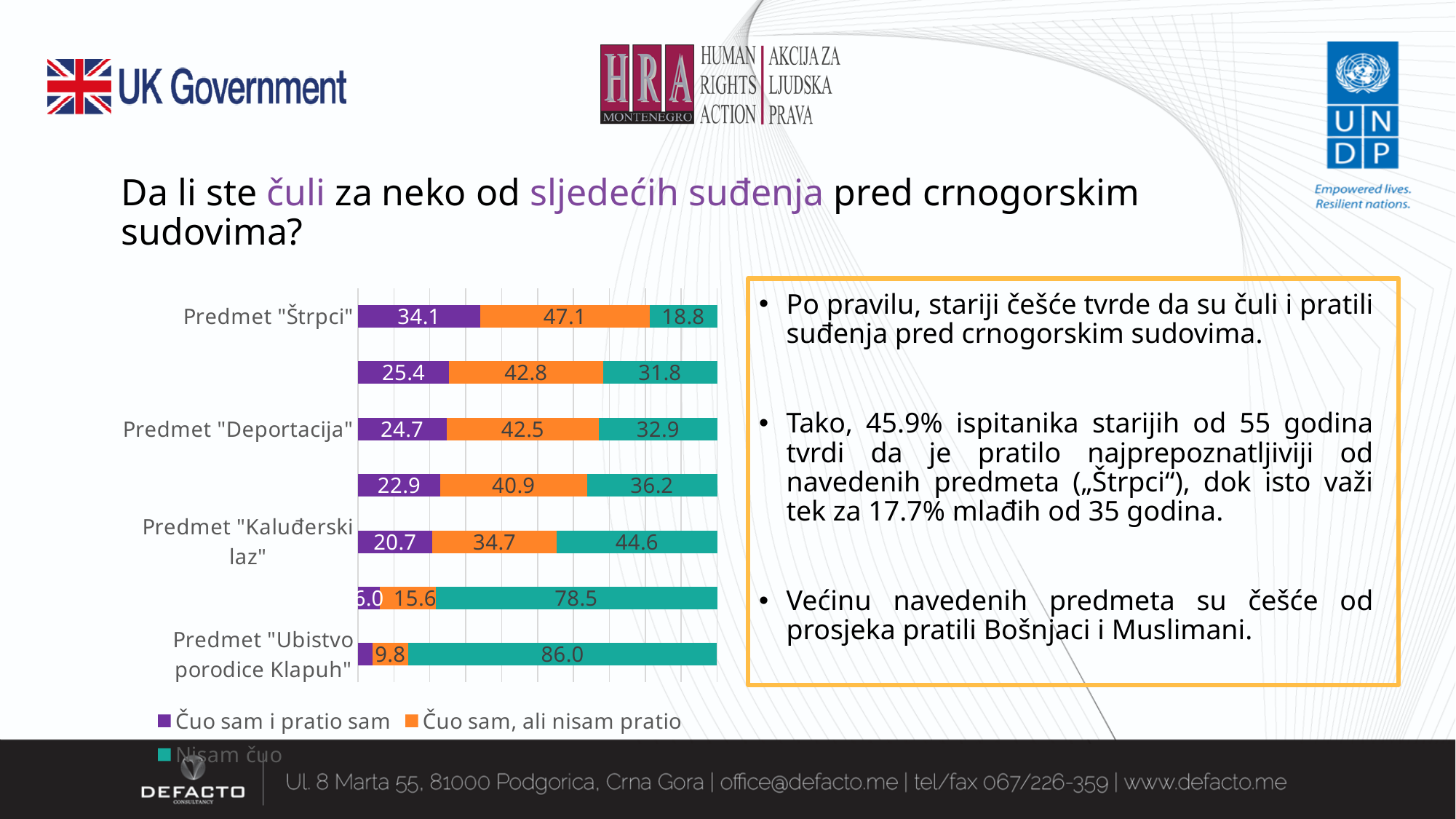
What kind of chart is shown on the slide? Stacked bar chart For Predmet "Štrpci", what is the difference between "Čuo sam, ali nisam pratio" and "Čuo sam i pratio sam"? 13.0 How many series does the chart legend list? 3 How many bars are plotted in the chart? 7 Which case has the highest "Čuo sam i pratio sam" value? Predmet "Štrpci" For Predmet "Kaluđerski laz", which is larger: "Nisam čuo" or "Čuo sam, ali nisam pratio"? Nisam čuo Which case has the highest "Nisam čuo" value? Predmet "Ubistvo porodice Klapuh" What is the value of "Nisam čuo" for Predmet "Kaluđerski laz"? 44.6 What is the value of "Nisam čuo" for Predmet "Štrpci"? 18.8 What is the value of "Nisam čuo" for Predmet "Ubistvo porodice Klapuh"? 86.0 What is the value of "Čuo sam i pratio sam" for Predmet "Štrpci"? 34.1 What is the value of "Čuo sam, ali nisam pratio" for Predmet "Deportacija"? 42.5